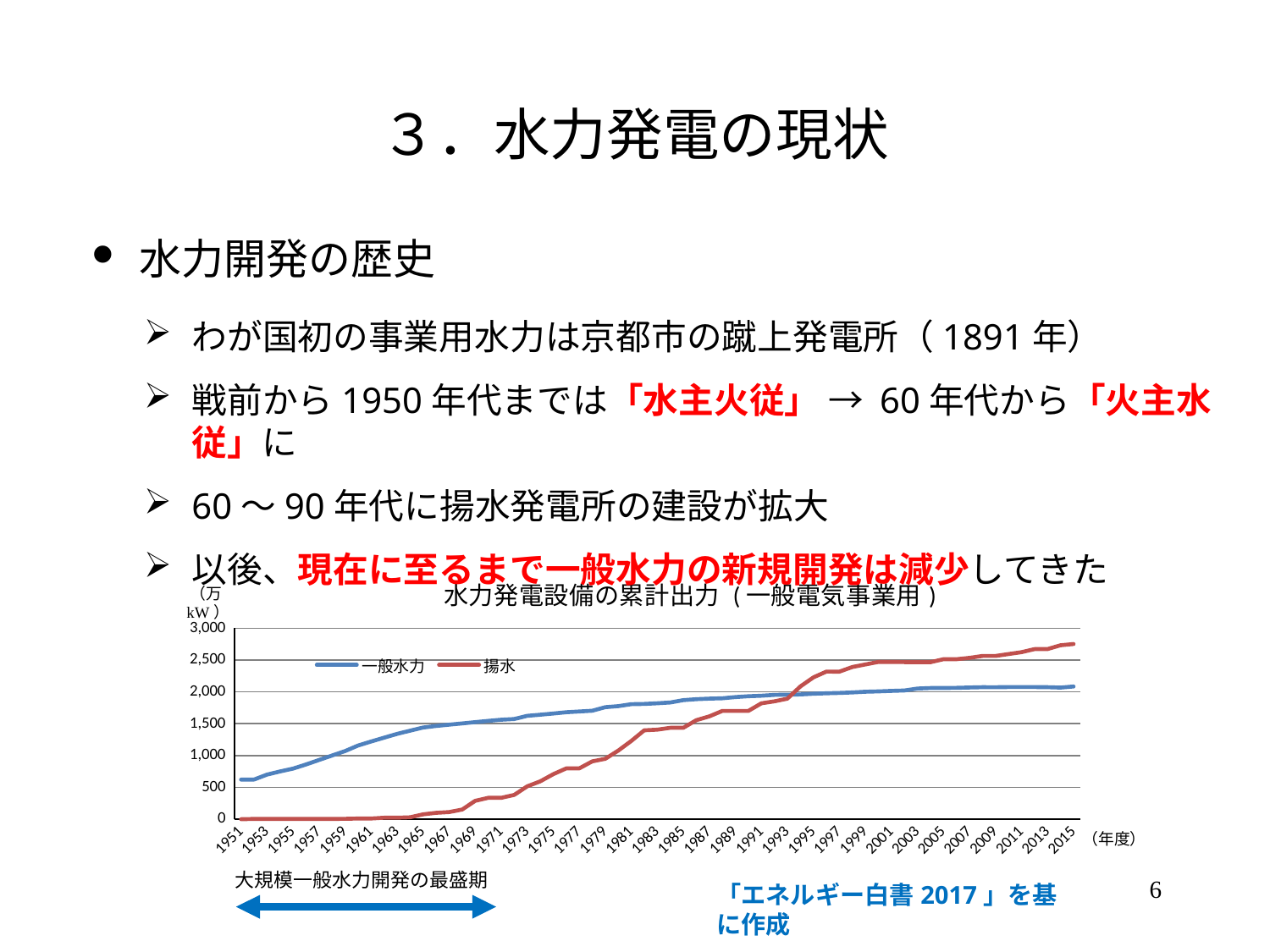
Does the 揚水 series rise or fall from 1951 to 2015? rise In 2015, which series has the higher value, 一般水力 or 揚水? 揚水 What kind of chart is shown on the slide? line chart Is the value for 一般水力 in 1951 greater or less than 500? greater In 1985, which series has the higher value, 一般水力 or 揚水? 一般水力 Is the value for 揚水 in 1971 greater or less than 500? less What are the two series named in the chart legend? 一般水力 and 揚水 How many series does the chart legend list? 2 What is the title of the chart? 水力発電設備の累計出力（一般電気事業用） Is the value for 一般水力 in 1981 greater or less than 1,500? greater